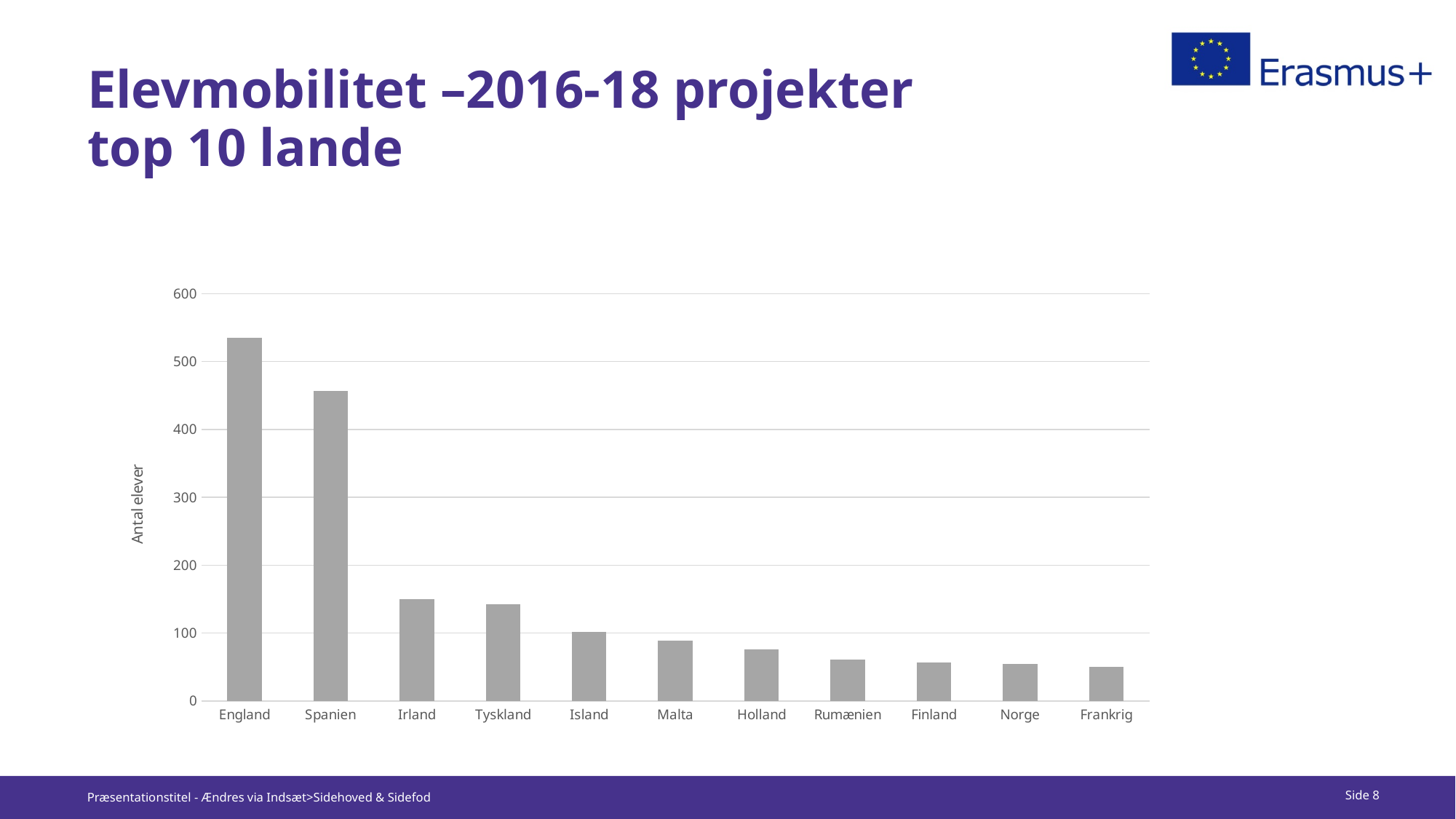
Which country has the highest number of students (Antal elever)? England Which has a larger value, England or Spanien? England Which has a larger value, Island or Malta? Island What is the label on the vertical axis of the chart? Antal elever What kind of chart is shown on the slide? bar chart Is the value for Spanien greater or less than 500? less How many countries are shown on the x axis of the chart? 11 Do the values rise or fall from left to right along the x axis? fall Is the value for Frankrig greater or less than 100? less Is the value for Irland greater or less than 100? greater